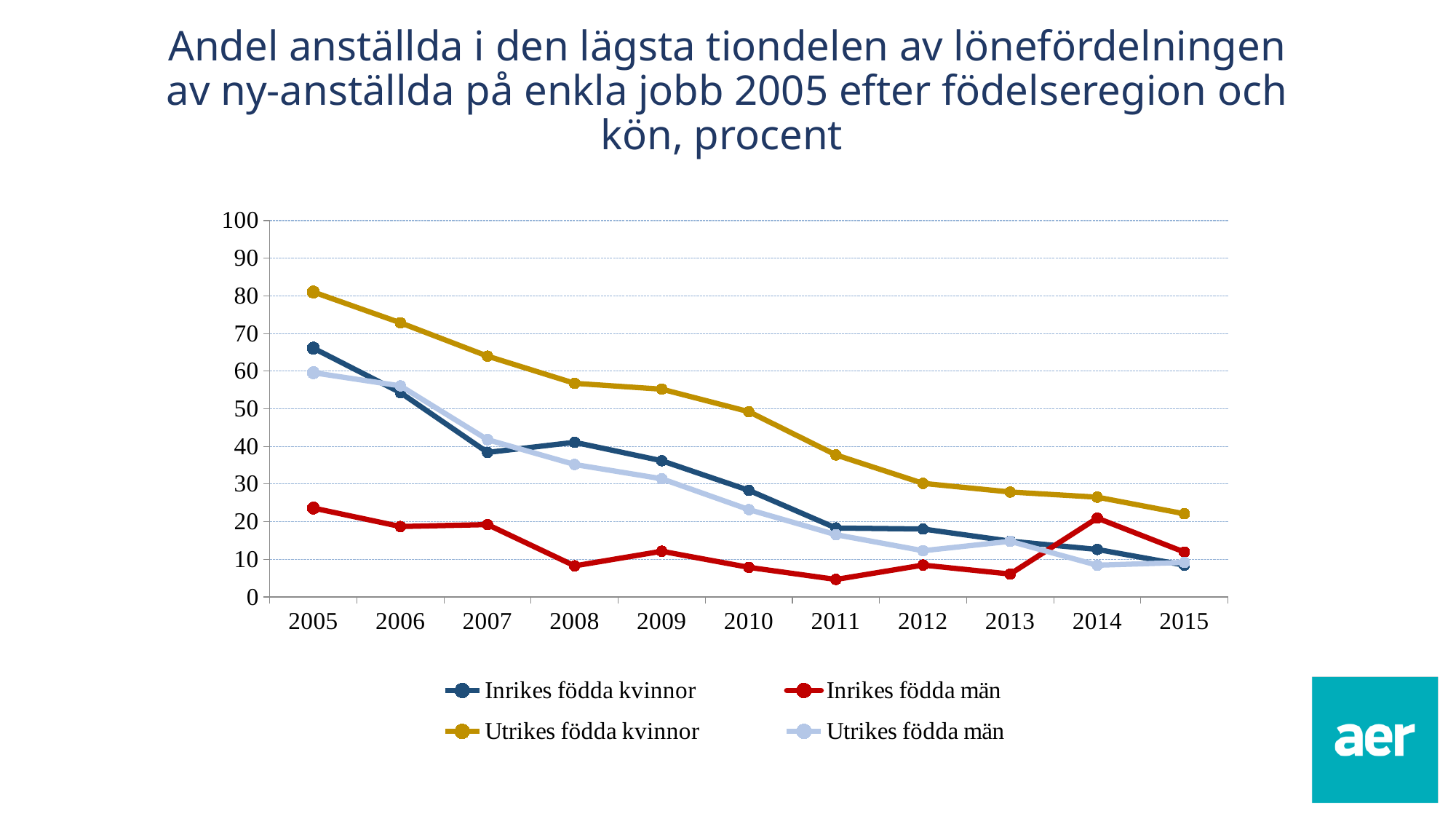
How many years are shown on the x axis? 11 Which series has the highest value in 2015? Utrikes födda kvinnor Which series has the highest value in 2005? Utrikes födda kvinnor Is the value for Utrikes födda kvinnor in 2005 greater or less than 70? greater How many series does the legend list? 4 Which series has the lowest value in 2005? Inrikes födda män What colour is the line for Inrikes födda män? red Does the value for Utrikes födda kvinnor rise or fall from 2005 to 2015? fall Is the value for Utrikes födda kvinnor in 2015 greater or less than 30? less What kind of chart is shown on the slide? line chart In 2010, which is larger: the value for Inrikes födda kvinnor or the value for Utrikes födda män? Inrikes födda kvinnor Is the value for Inrikes födda män in 2011 greater or less than 10? less